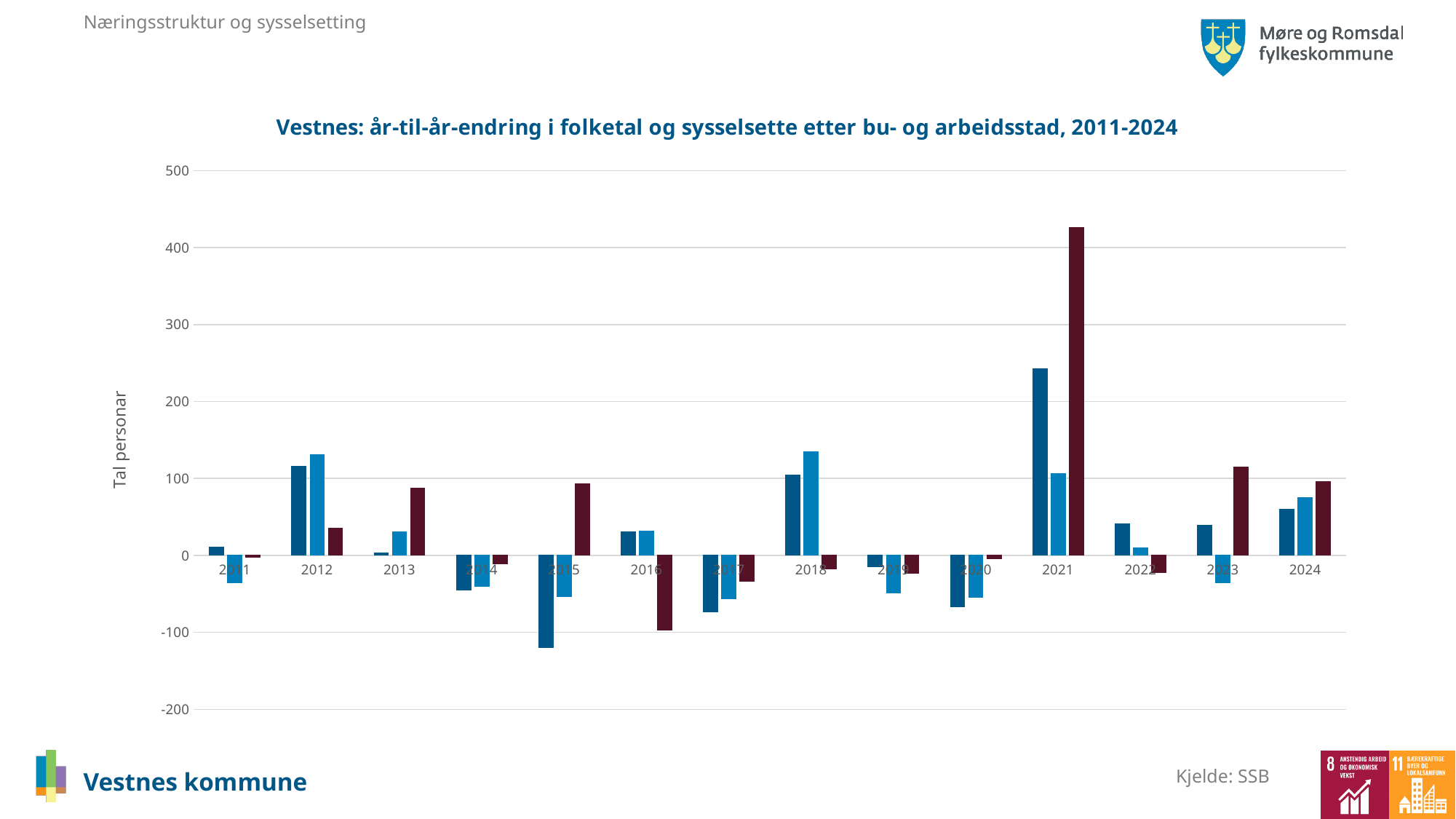
What kind of chart is shown on the slide? bar chart How many bars are plotted for each year in the chart? 3 Is the value of the dark red bar for 2021 greater or less than 400? greater In 2012, which is larger: the light blue bar or the dark red bar? the light blue bar Is the value of the dark blue bar for 2021 greater or less than 200? greater Is the value of the light blue bar for 2018 greater or less than 100? greater In which year does the chart show its lowest (most negative) bar? 2015 What is the title of the chart? Vestnes: år-til-år-endring i folketal og sysselsette etter bu- og arbeidsstad, 2011-2024 What source is cited for the chart? SSB How many years are shown along the x axis of the chart? 14 In which year does the chart show its tallest bar? 2021